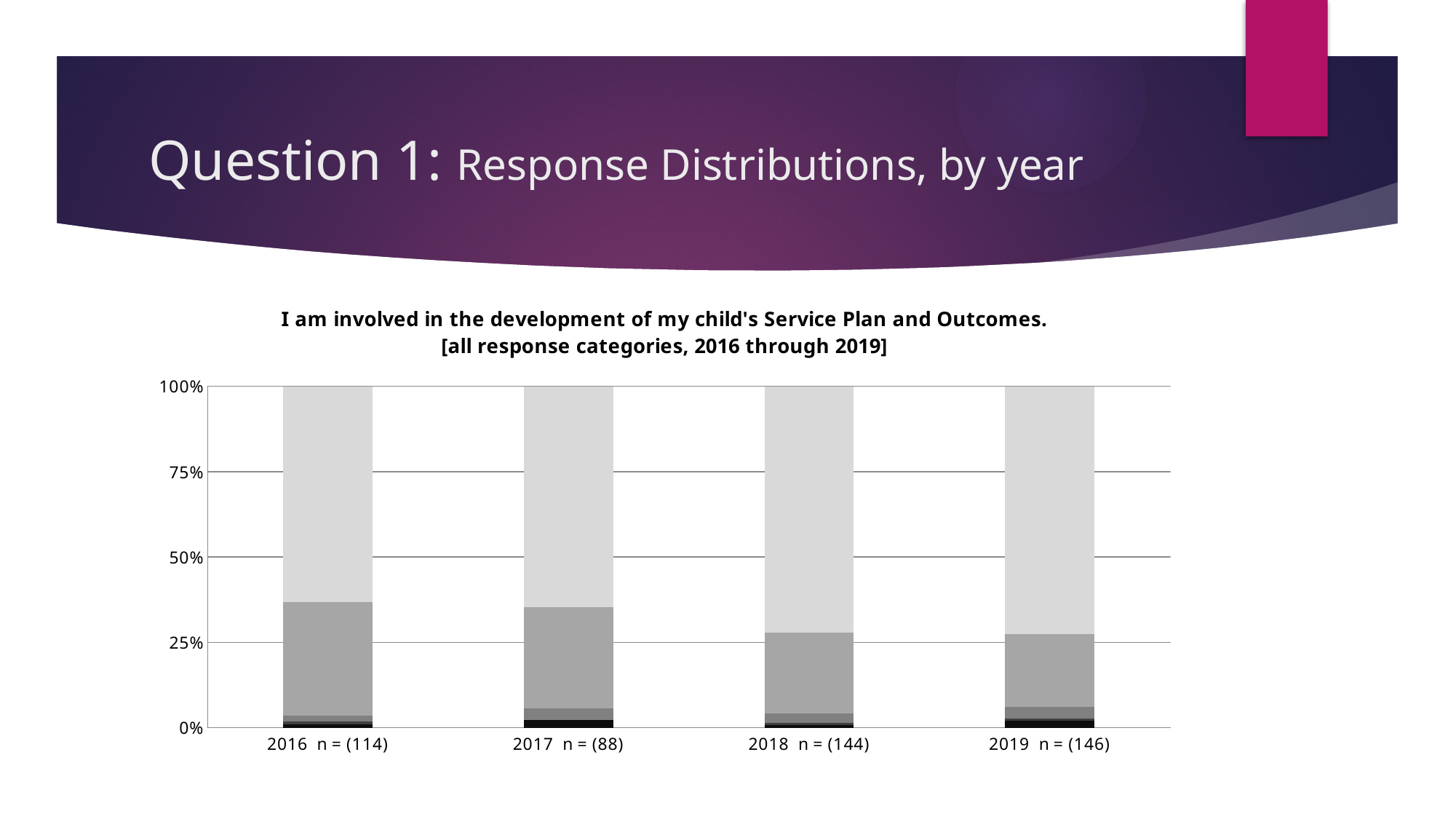
What is the sample size (n) shown for 2017 in the chart? 88 What is the sample size (n) shown for 2019 in the chart? 146 Is the top of the medium-gray segment for 2016 greater or less than 50%? less Is the top of the medium-gray segment for 2016 greater or less than 25%? greater Which year has the smallest sample size (n) in the chart? 2017 What is the first line of the chart's title? I am involved in the development of my child's Service Plan and Outcomes. Which year has the larger medium-gray segment, 2016 or 2018? 2016 What is the sample size (n) shown for 2018 in the chart? 144 Which year has the largest sample size (n) in the chart? 2019 What type of chart is shown on the slide? Stacked bar chart What is the sample size (n) shown for 2016 in the chart? 114 How many years (categories) are shown on the x axis of the chart? 4